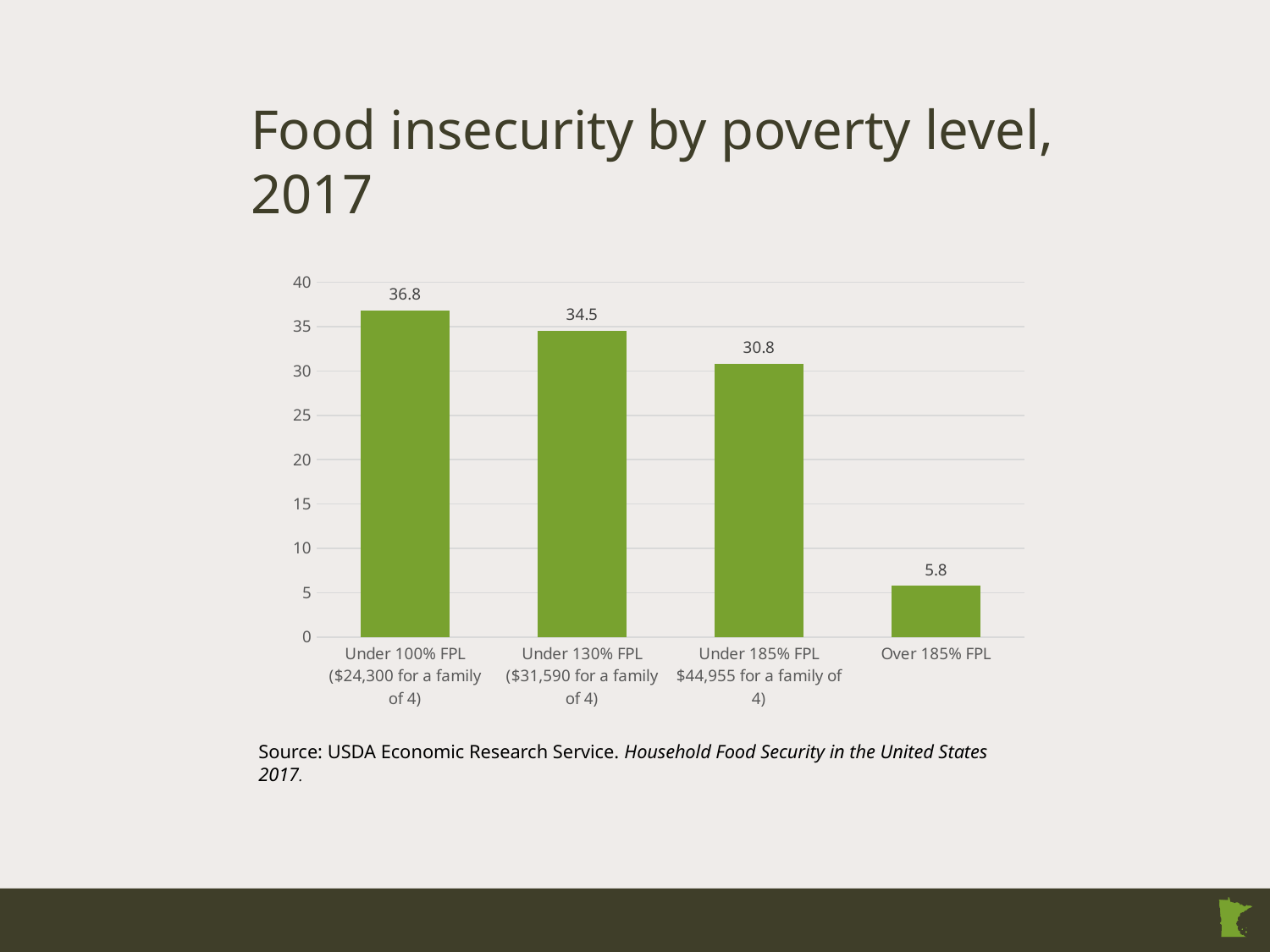
What is the difference between the values for Under 130% FPL and Under 185% FPL? 3.7 What is the value for Over 185% FPL? 5.8 What kind of chart is shown on the slide? Bar chart What is the title of the chart on the slide? Food insecurity by poverty level, 2017 Which category has the lowest value? Over 185% FPL What is the difference between the values for Under 100% FPL and Over 185% FPL? 31.0 How many categories are shown in the chart? 4 What is the value for Under 100% FPL? 36.8 What is the value for Under 185% FPL? 30.8 Which is larger, the value for Under 130% FPL or Under 185% FPL? Under 130% FPL What is the value for Under 130% FPL? 34.5 Which category has the highest value? Under 100% FPL